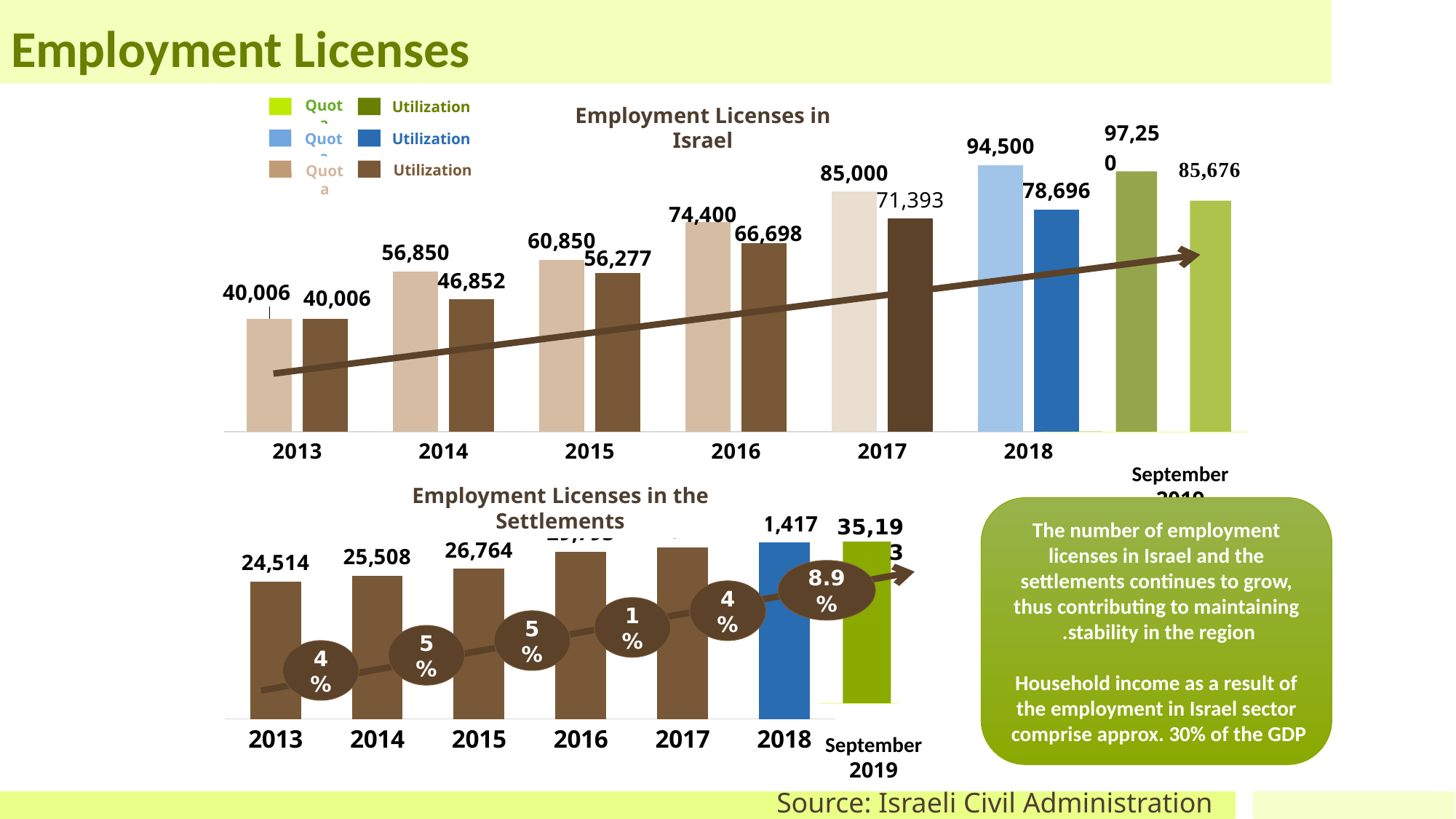
In the 'Employment Licenses in Israel' chart, which year has the lowest Quota value? 2013 How many periods are shown on the x axis of the 'Employment Licenses in Israel' chart? 7 In the 'Employment Licenses in Israel' chart, do the Quota values rise or fall from 2013 to September 2019? Rise In the 'Employment Licenses in Israel' chart, what is the Utilization value for 2018? 78,696 In the 'Employment Licenses in the Settlements' chart, what percentage label is shown on the trend line for September 2019? 8.9% In the 'Employment Licenses in Israel' chart, which period has the highest Utilization value? September 2019 In the 'Employment Licenses in the Settlements' chart, what is the difference between the 2014 and 2013 values? 994 What kind of chart is 'Employment Licenses in Israel'? Bar chart In the 'Employment Licenses in Israel' chart, what is the difference between the Quota and Utilization values for 2014? 9,998 In the 'Employment Licenses in the Settlements' chart, what is the value for 2013? 24,514 In the 'Employment Licenses in Israel' chart, which is larger: the Quota for 2016 or the Utilization for 2017? Quota for 2016 In the 'Employment Licenses in Israel' chart, what is the Quota value for 2017? 85,000